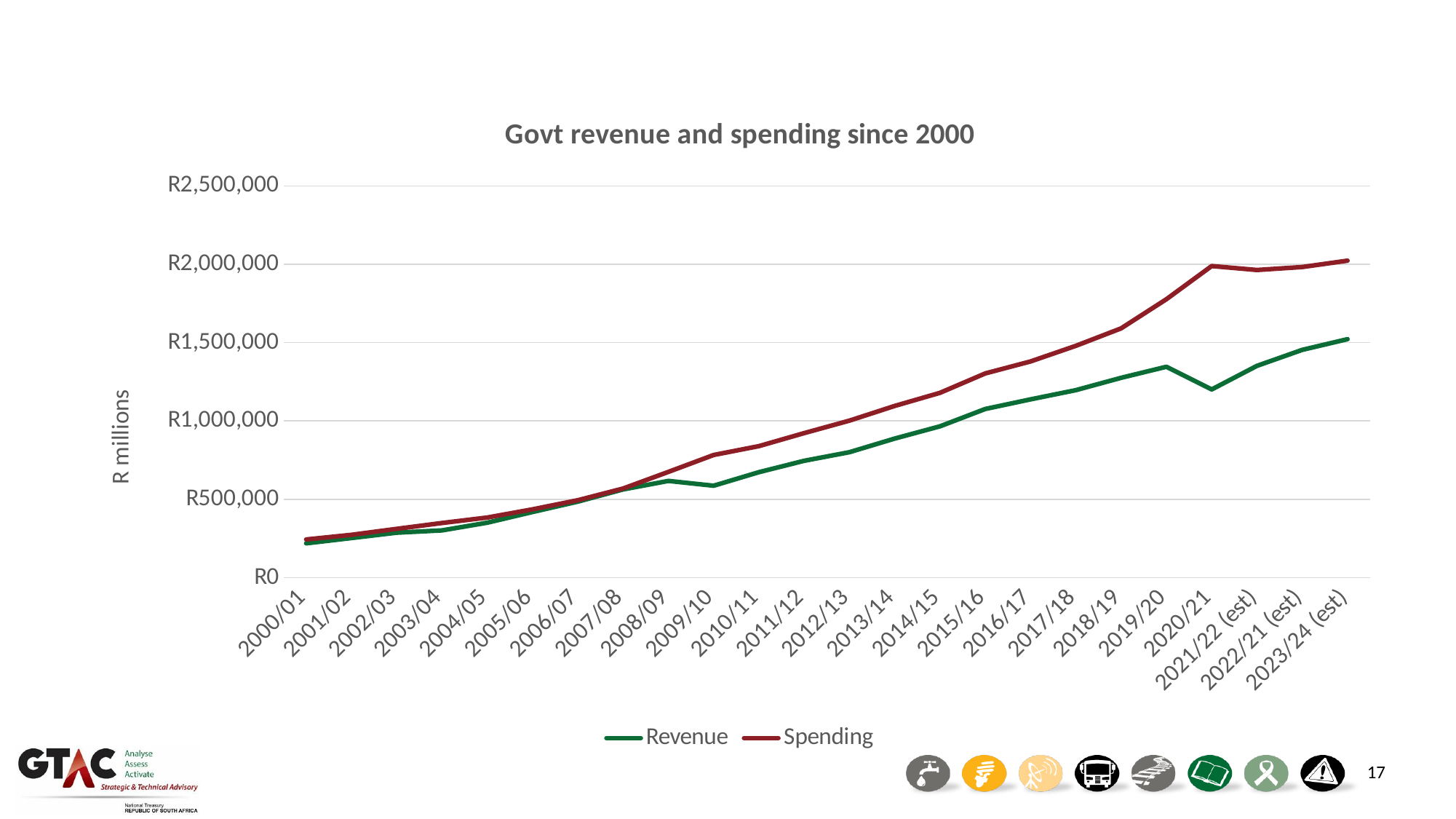
Is the Revenue value for 2020/21 greater or less than R1,000,000? greater Is the Spending value for 2018/19 greater or less than R1,500,000? greater How many series does the legend list? 2 In 2020/21, which is larger, Revenue or Spending? Spending In which year is Revenue at its lowest? 2000/01 Is the Revenue value for 2000/01 greater or less than R500,000? less What kind of chart is shown on the slide? line chart What is the title of the chart? Govt revenue and spending since 2000 Does Spending generally rise or fall from 2000/01 to 2023/24 (est)? rise What is the label on the vertical axis? R millions How many fiscal years are plotted along the x axis? 24